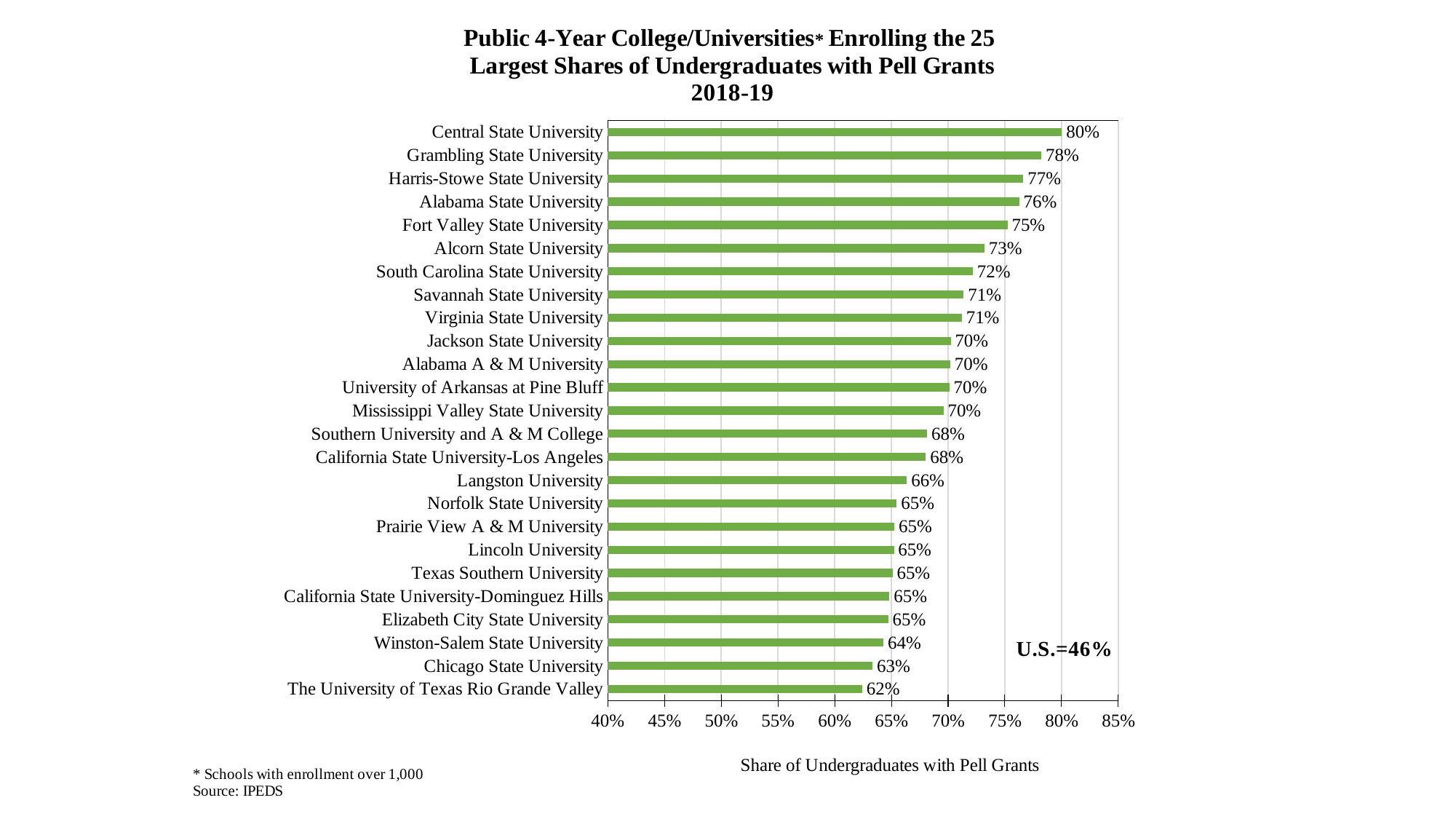
Which university has the highest share of undergraduates with Pell Grants on the chart? Central State University What is the label of the horizontal axis? Share of Undergraduates with Pell Grants Is the value for Winston-Salem State University greater or less than 70%? less Which university has the lowest share of undergraduates with Pell Grants on the chart? The University of Texas Rio Grande Valley What share of undergraduates with Pell Grants does Central State University have? 80% What kind of chart is shown on the slide? bar chart What is the difference between the values for Grambling State University and Langston University? 12% What is the value shown for Alcorn State University? 73% Which has a larger share of undergraduates with Pell Grants, Fort Valley State University or Savannah State University? Fort Valley State University How many universities are listed on the chart? 25 What is the U.S. value noted on the chart? 46% What share of undergraduates with Pell Grants is shown for Chicago State University? 63%